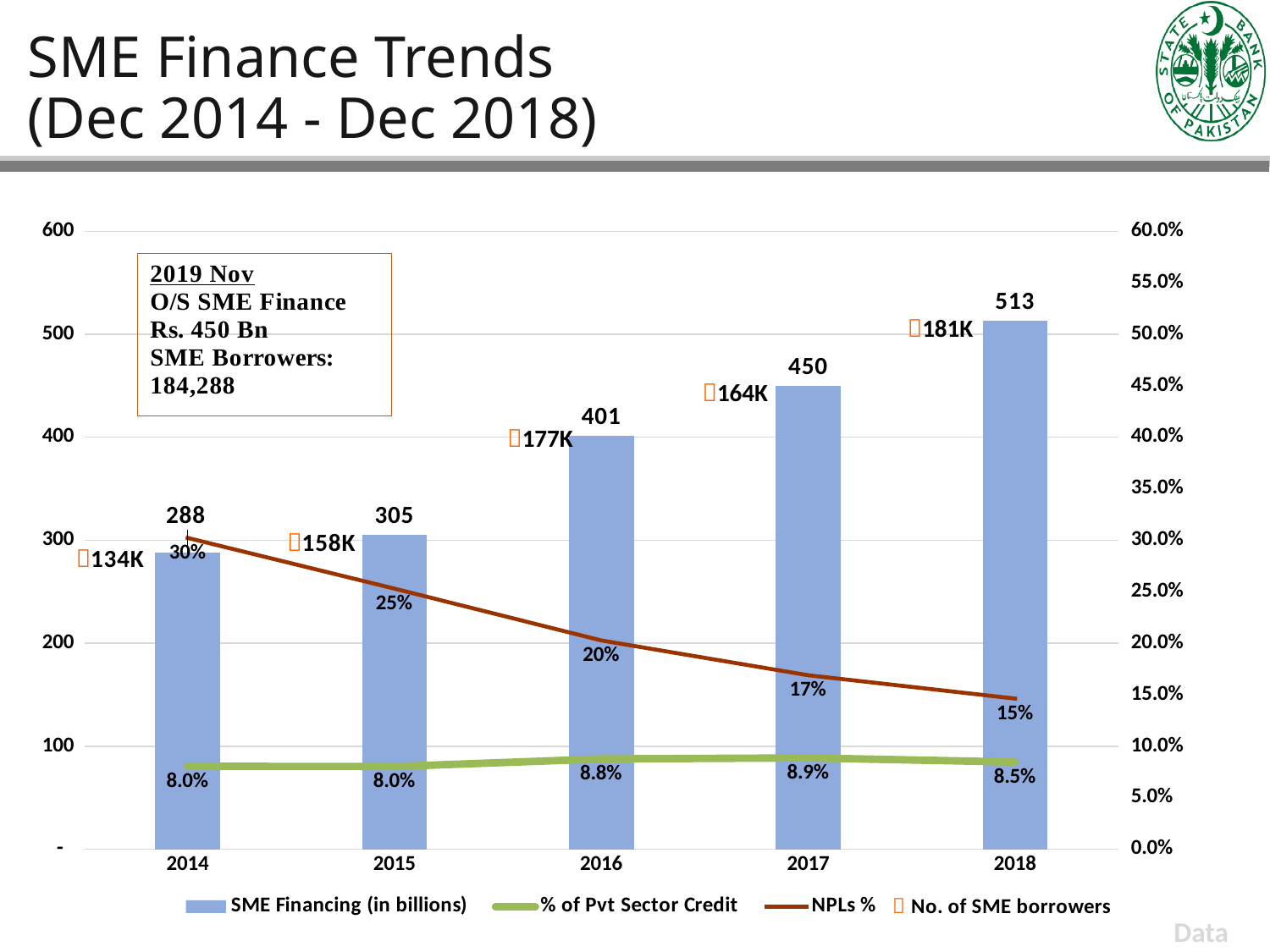
What is the difference between the SME Financing (in billions) values for 2018 and 2014? 225 Which is larger, the No. of SME borrowers in 2016 or in 2017? 2016 Which year has the lowest NPLs % value? 2018 What is the No. of SME borrowers value for 2016? 177K What is the NPLs % value for 2014? 30% What is the % of Pvt Sector Credit value for 2017? 8.9% How many years are shown on the x axis? 5 Which year has the highest SME Financing (in billions) value? 2018 How many series does the legend list? 4 Does the NPLs % line rise or fall from 2014 to 2018? fall What is the SME Financing (in billions) value for 2018? 513 Is the SME Financing (in billions) value for 2016 greater or less than 300? greater